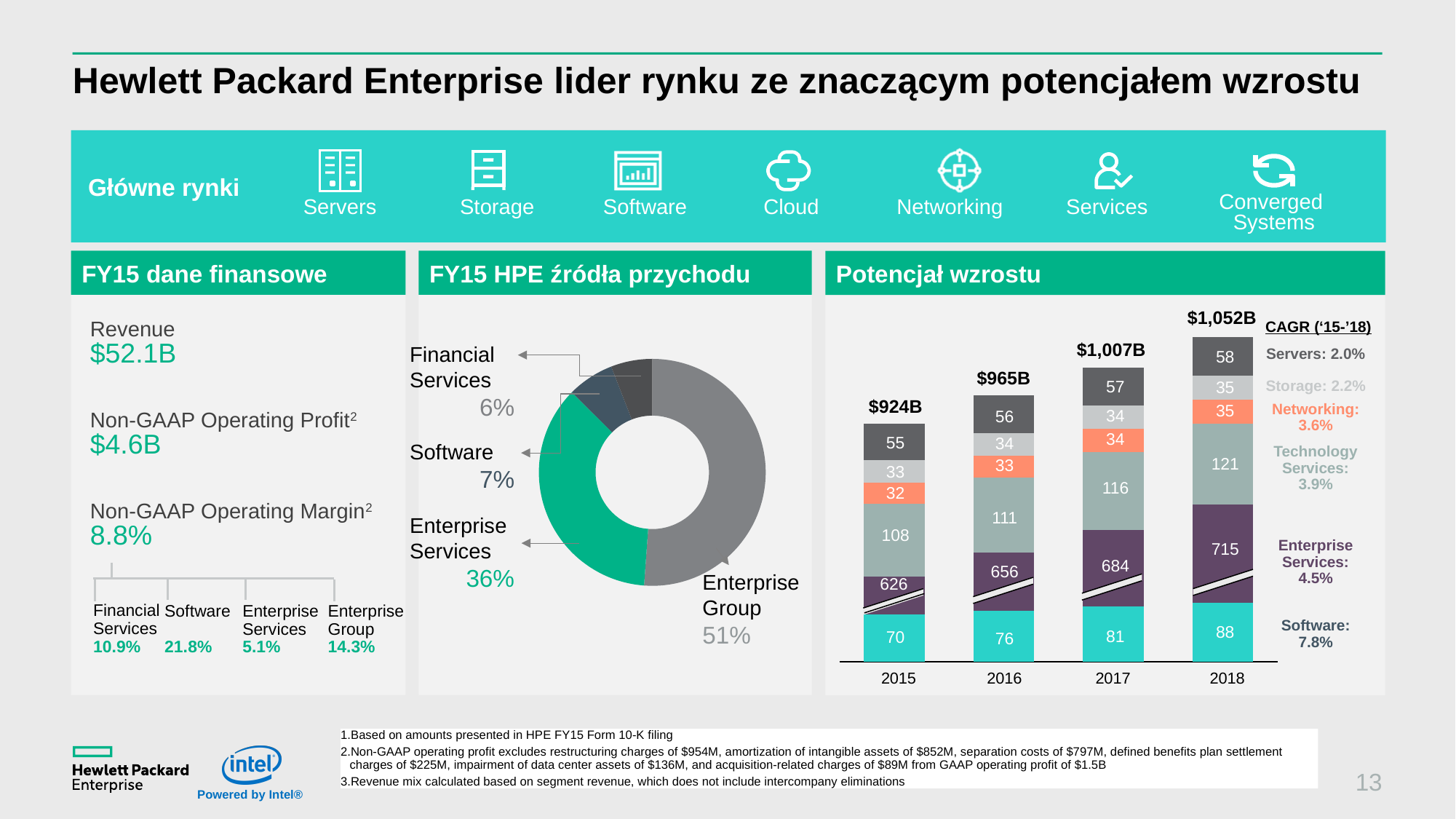
How many segments does the 'FY15 HPE źródła przychodu' chart show? 4 In the 'FY15 HPE źródła przychodu' chart, what share of revenue comes from Enterprise Group? 51% In the 'FY15 HPE źródła przychodu' chart, which segment has the smallest share? Financial Services What kind of chart is the 'FY15 HPE źródła przychodu' chart? Donut (pie) chart In the 'Potencjał wzrostu' chart, how many years are shown on the x axis? 4 In the 'Potencjał wzrostu' chart, which segment has the highest CAGR ('15-'18)? Software: 7.8% In the 'Potencjał wzrostu' chart, what is the total for the 2018 bar? $1,052B In the 'Potencjał wzrostu' chart, do the bar totals rise or fall from 2015 to 2018? Rise In the 'FY15 HPE źródła przychodu' chart, what share of revenue comes from Enterprise Services? 36% In the 'Potencjał wzrostu' chart, what is the Enterprise Services value for 2017? 684 In the 'Potencjał wzrostu' chart, what is the difference between the Software values for 2018 and 2015? 18 In the 'Potencjał wzrostu' chart, what is the Software value for 2016? 76